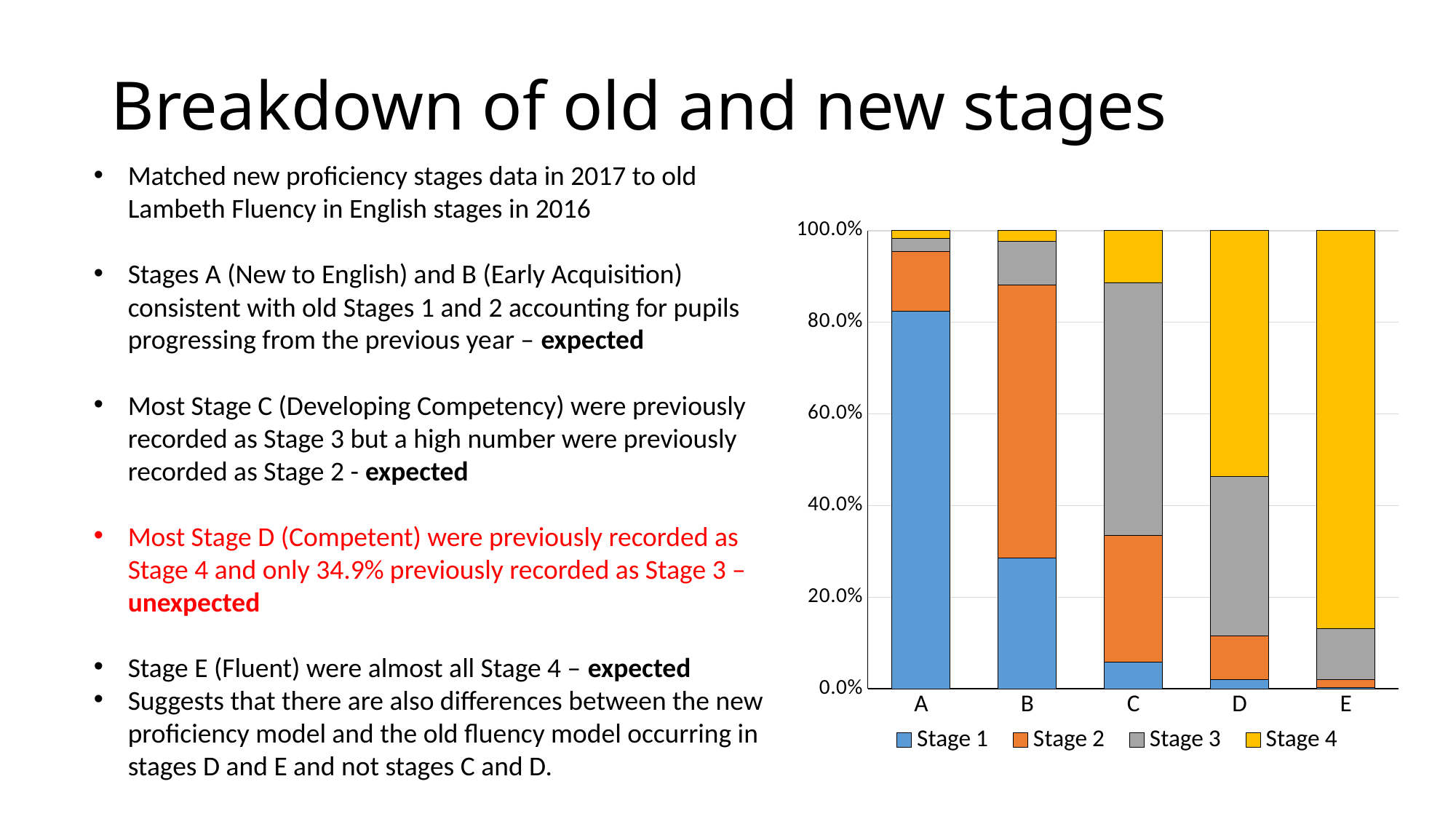
Is the Stage 1 share for category B greater or less than 20.0%? greater Is the Stage 1 share for category A greater or less than 80.0%? greater What kind of chart is shown on the slide? Stacked bar chart Which category has the largest Stage 1 share? A Does the Stage 1 share rise or fall moving from category A to category E? Fall How many categories are shown on the x axis of the chart? 5 Which is larger: the Stage 4 share for category D or for category E? E Is the Stage 4 share for category E greater or less than 80.0%? greater Which category has the largest Stage 2 share? B How many series does the chart's legend list? 4 Which colour represents Stage 3 in the chart's legend? Grey Which category has the largest Stage 4 share? E